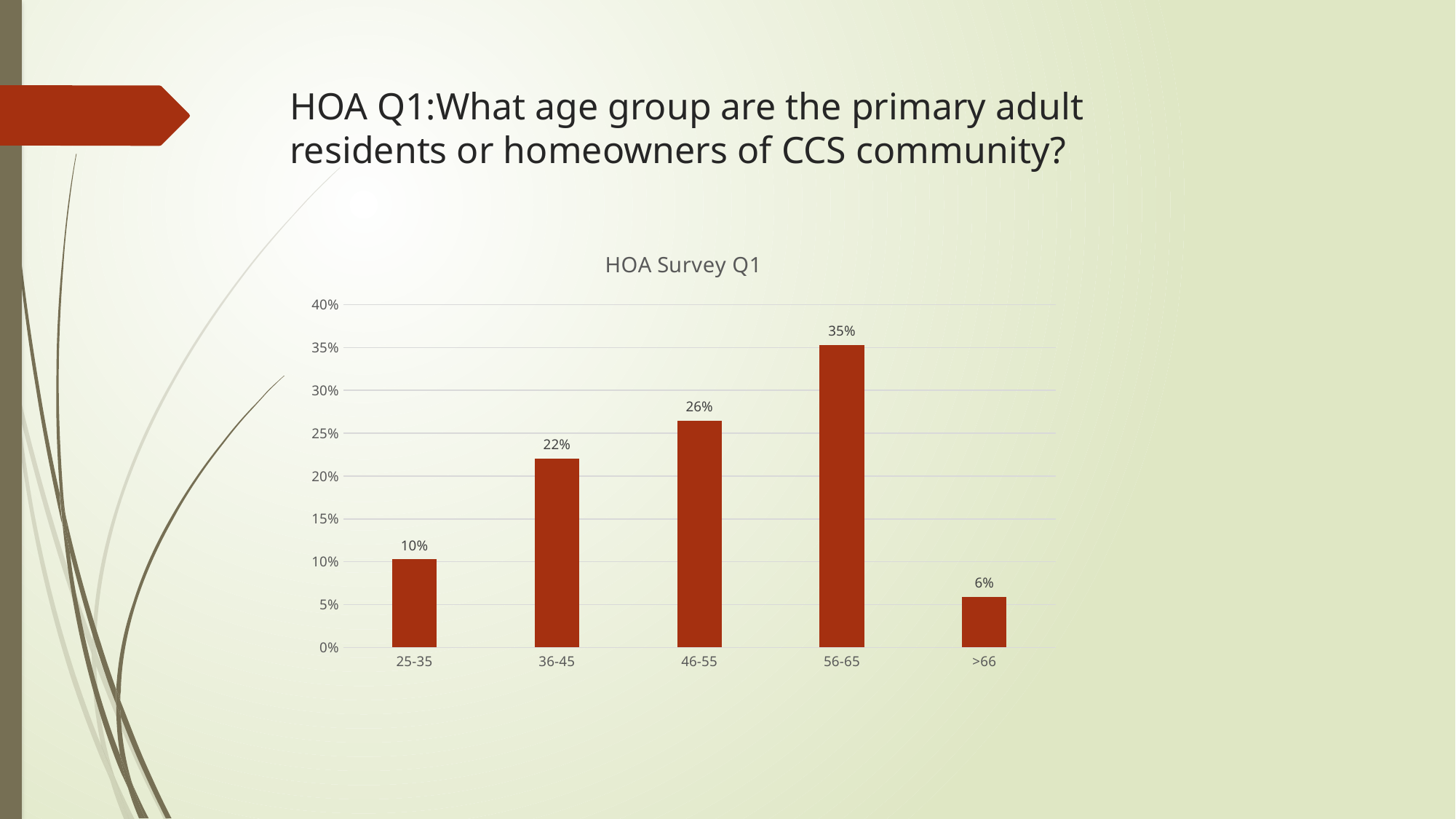
Is the value for 56-65 greater or less than 30%? greater What kind of chart is shown? bar chart What is the title of the chart? HOA Survey Q1 What is the value for the 36-45 age group? 22% What is the difference between the values for 56-65 and 25-35? 25% How many age groups are shown on the x axis? 5 Which age group has the lowest value? >66 What is the value for the 25-35 age group? 10% What is the value for the 46-55 age group? 26% Which age group has the highest value? 56-65 Which is larger, the value for 36-45 or the value for 46-55? 46-55 What is the value for the >66 age group? 6%